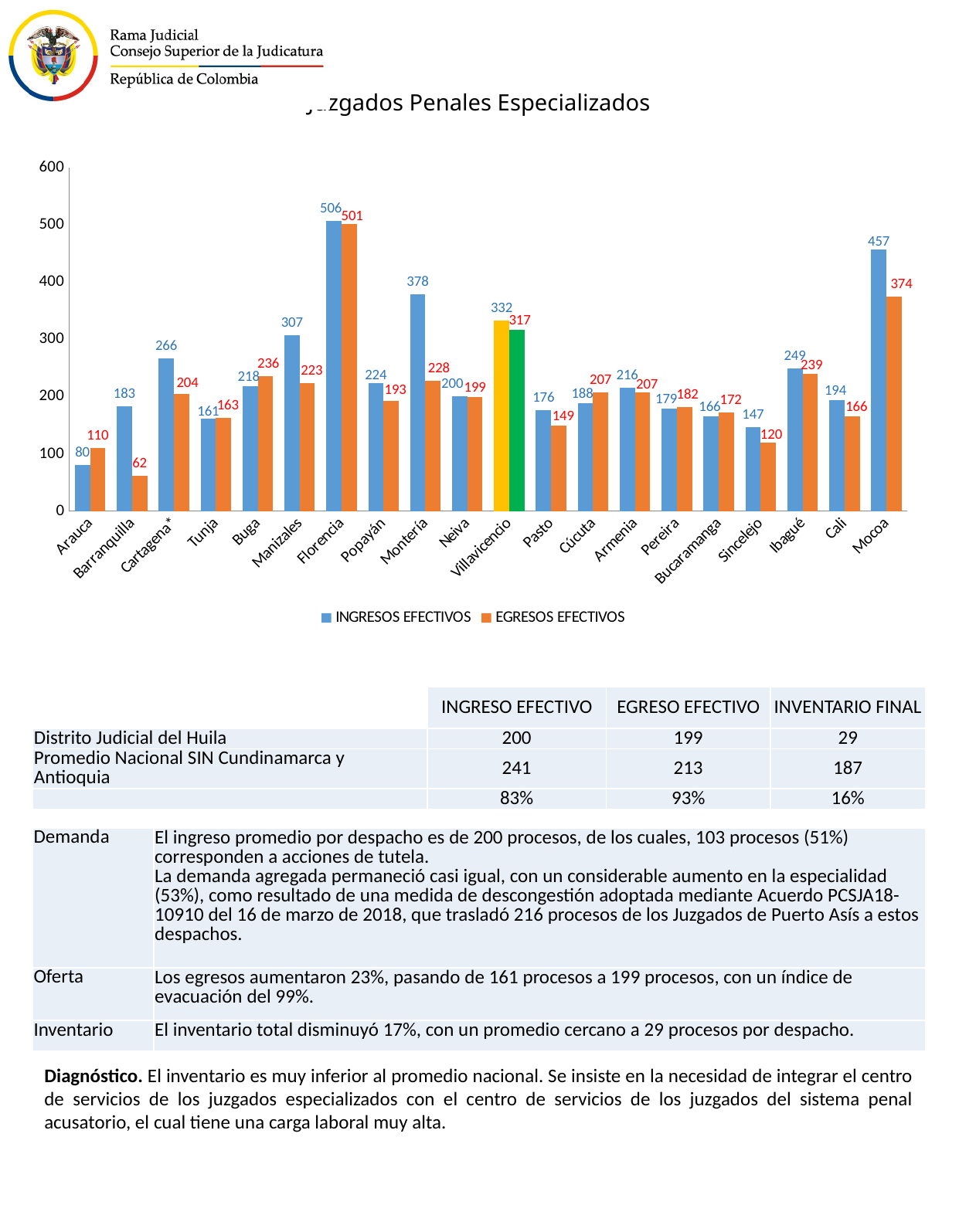
Which city's bars are coloured yellow and green instead of blue and orange? Villavicencio How many series does the chart legend list? 2 What kind of chart is shown on the slide? Bar chart Is the INGRESOS EFECTIVOS value for Mocoa greater or less than 400? greater Which city has the highest INGRESOS EFECTIVOS? Florencia Which is larger for Cúcuta, INGRESOS EFECTIVOS or EGRESOS EFECTIVOS? EGRESOS EFECTIVOS What is the value of INGRESOS EFECTIVOS for Florencia? 506 Which city has the lowest INGRESOS EFECTIVOS? Arauca How many cities are shown on the x axis of the chart? 20 What is the value of EGRESOS EFECTIVOS for Mocoa? 374 What is the difference between INGRESOS EFECTIVOS and EGRESOS EFECTIVOS for Montería? 150 What is the value of EGRESOS EFECTIVOS for Barranquilla? 62